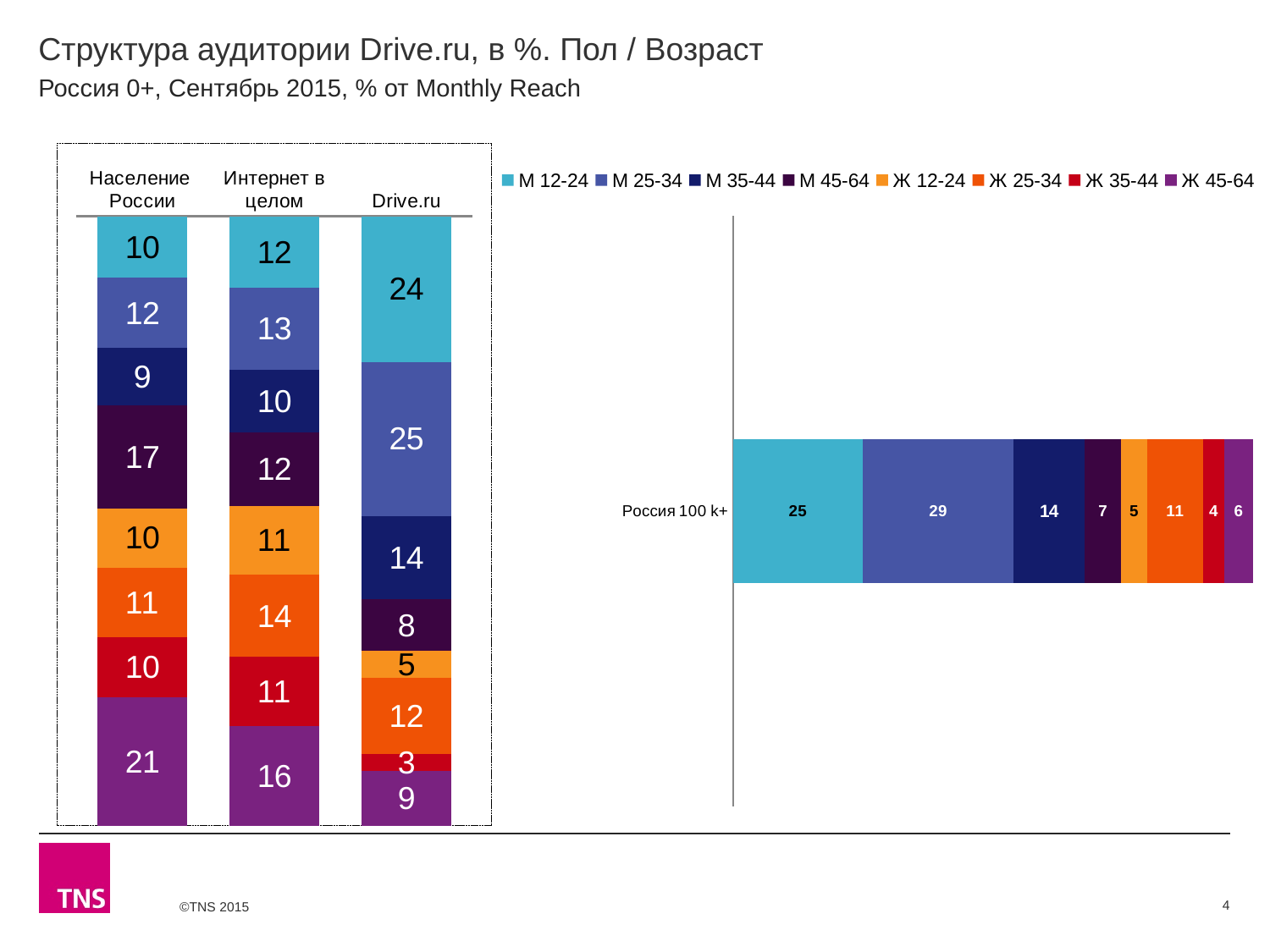
In the left chart, what is the value of the Ж 45-64 segment for Население России? 21 In the left chart, what is the value of the Ж 25-34 segment for Интернет в целом? 14 How many bars (categories) are shown in the left chart? 3 What kind of chart is the right chart? Stacked bar chart In the left chart, which segment is the smallest in the Drive.ru bar? Ж 35-44 How many series does the legend list? 8 In the left chart, which is larger: the Ж 45-64 value for Население России or for Интернет в целом? Население России In the left chart, what is the difference between the М 12-24 values for Drive.ru and Население России? 14 In the right chart, which segment is the smallest for Россия 100 k+? Ж 35-44 In the left chart, which segment is the largest in the Drive.ru bar? М 25-34 In the left chart, what is the value of the М 12-24 segment for Drive.ru? 24 In the right chart, what is the value of the М 25-34 segment for Россия 100 k+? 29